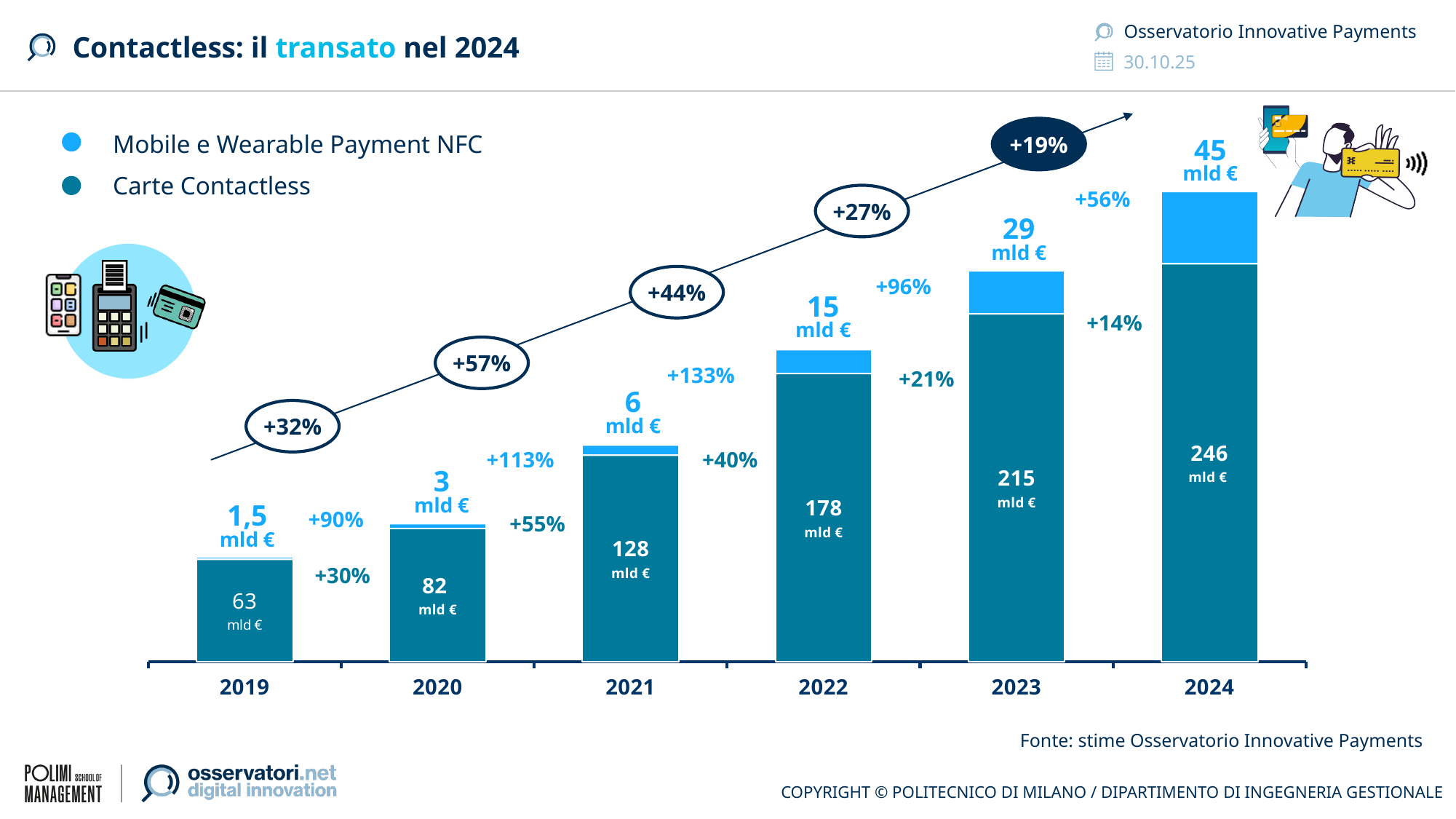
What is the value for Mobile e Wearable Payment NFC in 2019? 1,5 mld € How many series does the legend list? 2 Which year has the highest value for Carte Contactless? 2024 What is the value for Carte Contactless in 2021? 128 mld € What kind of chart is shown on the slide? Stacked bar chart What is the difference between the Carte Contactless values for 2023 and 2022? 37 mld € Which is larger: Carte Contactless in 2020 or Carte Contactless in 2021? Carte Contactless in 2021 What is the value for Carte Contactless in 2024? 246 mld € What is the value for Mobile e Wearable Payment NFC in 2023? 29 mld € What is the total of the stacked bar for 2022? 193 mld € Which year has the lowest value for Mobile e Wearable Payment NFC? 2019 How many years are shown on the x axis? 6